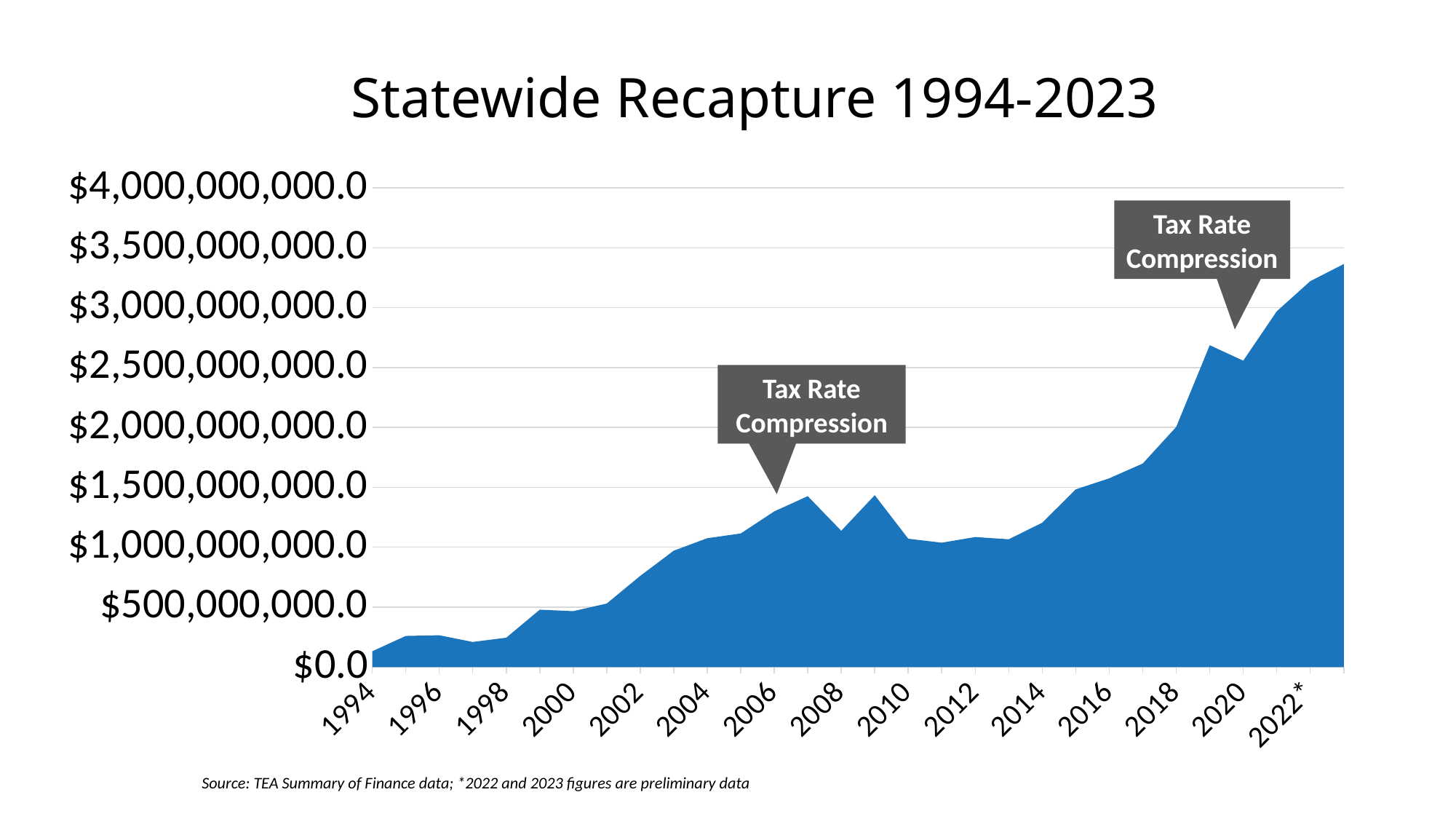
Is the value for 2014 greater or less than $1,000,000,000.0? greater What text appears in the two callout boxes on the chart? Tax Rate Compression Is the value for 2022 greater or less than $3,000,000,000.0? greater Is the value for 2006 greater or less than $1,000,000,000.0? greater What is the title of the chart? Statewide Recapture 1994-2023 Which year has the highest statewide recapture value? 2023 Which year has the lowest statewide recapture value? 1994 Which year has the larger value, 2000 or 2004? 2004 What kind of chart is shown on the slide? Area chart How many year labels are shown on the x axis? 15 Overall, do the values rise or fall from 1994 to 2023? Rise